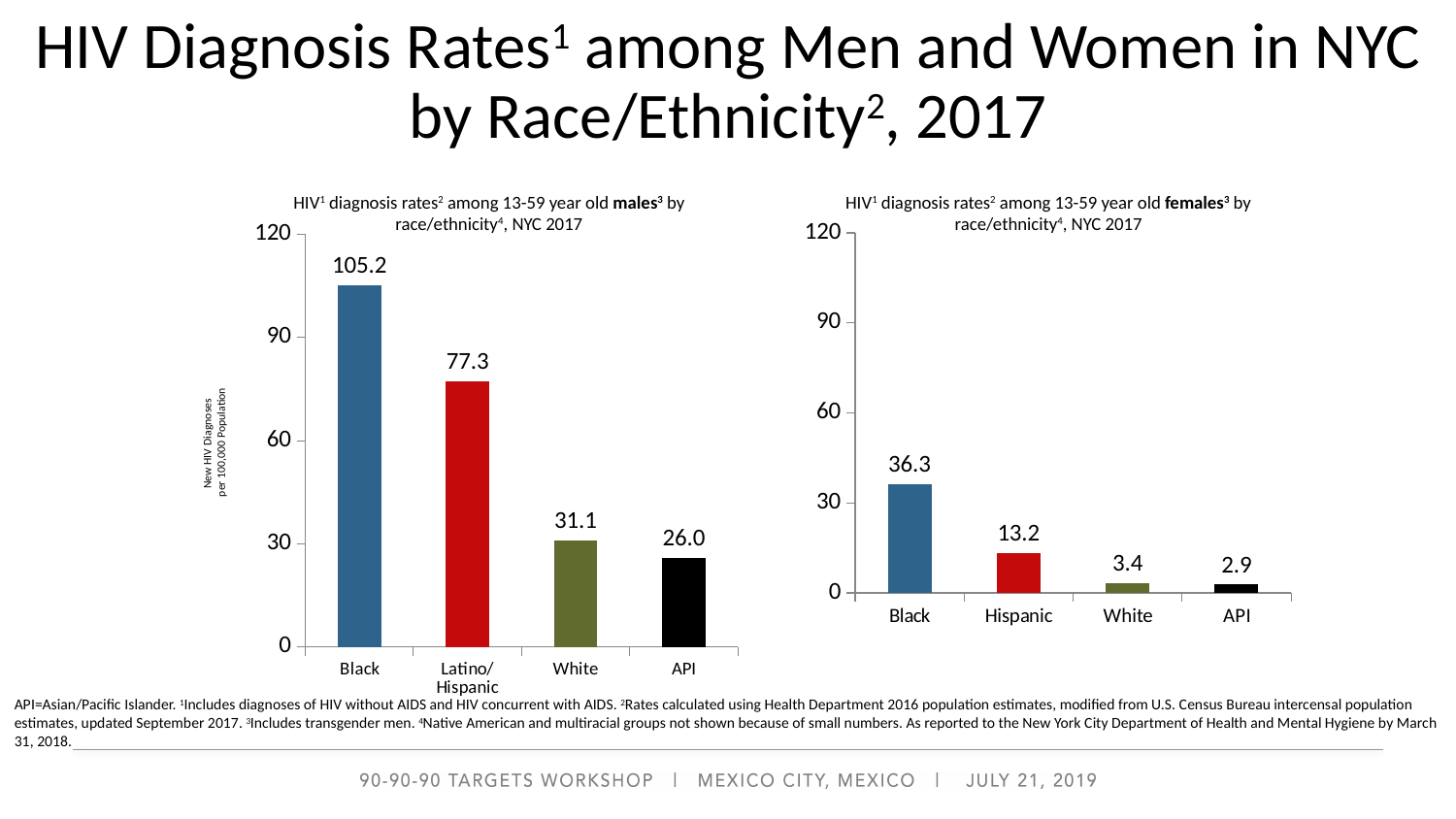
In the males chart (left), which is larger: the rate for White males or API males? White How many race/ethnicity categories are shown in the females chart (right)? 4 In the females chart (right), which race/ethnicity has the highest HIV diagnosis rate? Black In the females chart (right), is the value for Black females greater or less than 30? greater What is the maximum value shown on the y-axis of the males chart (left)? 120 What type of chart is the males chart (left)? bar chart In the females chart (right), do the values rise or fall from left to right across the categories? fall In the females chart (right), what is the HIV diagnosis rate for Hispanic females? 13.2 In the males chart (left), what is the difference between the rates for Black and Latino/Hispanic males? 27.9 In the males chart (left), which race/ethnicity has the lowest HIV diagnosis rate? API In the females chart (right), what is the difference between the rates for White and API females? 0.5 In the males chart (left), what is the HIV diagnosis rate for Black males? 105.2